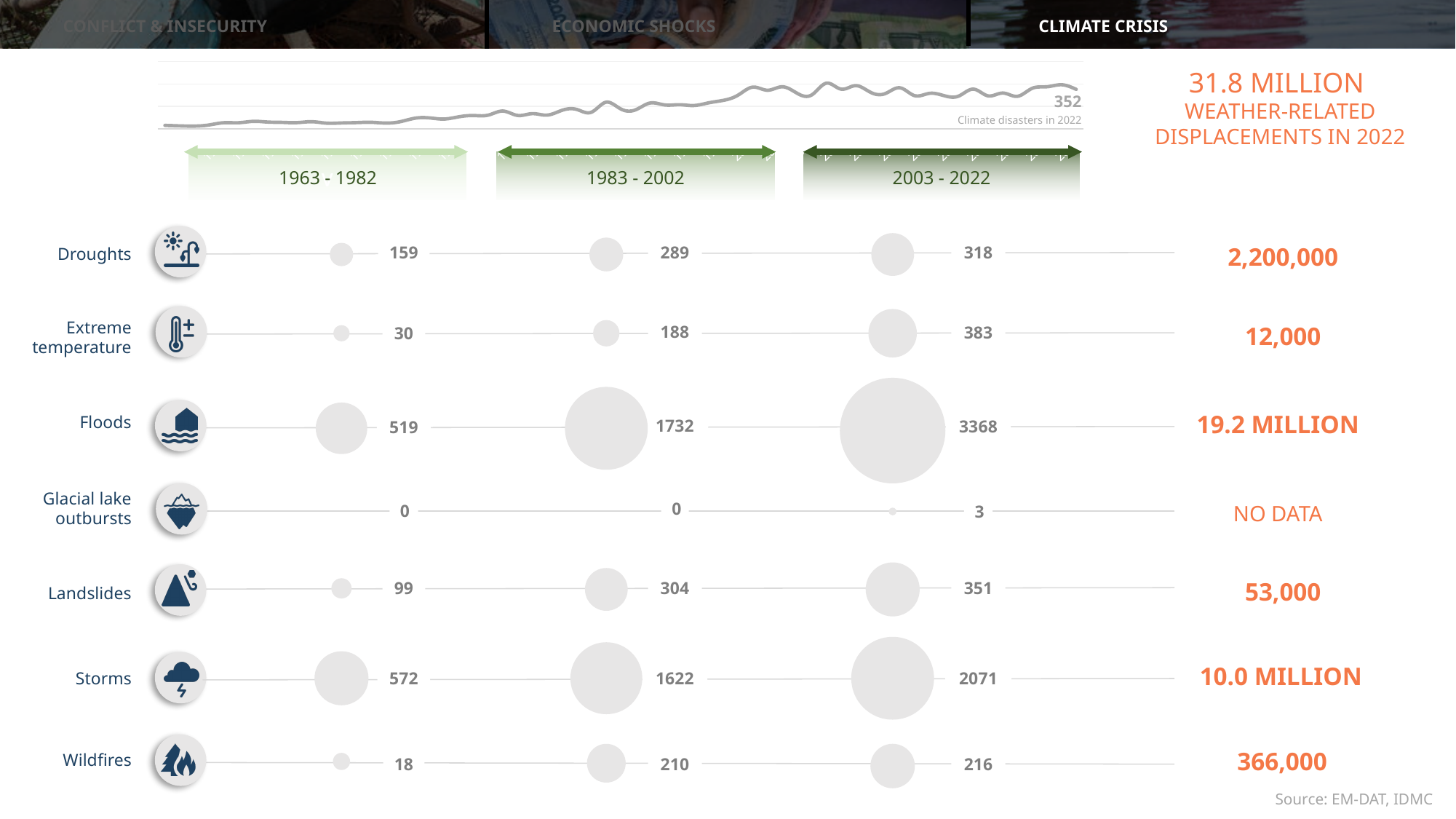
What value is labelled at the end of the line chart for climate disasters in 2022? 352 Which disaster type has the highest count in the period 2003 - 2022? Floods Which disaster type has the lowest count in the period 1963 - 1982? Glacial lake outbursts How many disaster types are listed in the chart? 7 How many wildfires are recorded for 1963 - 1982? 18 What is the number of storms in the period 1983 - 2002? 1622 How many weather-related displacements were caused by storms in 2022? 10.0 MILLION Do the counts for landslides rise or fall across the three periods from 1963 - 1982 to 2003 - 2022? Rise How many floods are shown for the period 2003 - 2022? 3368 Which is larger: the number of droughts in 2003 - 2022 or the number of extreme temperature events in 2003 - 2022? Extreme temperature (383) What is the total number of weather-related displacements in 2022 stated on the slide? 31.8 MILLION What is the difference between the number of floods in 2003 - 2022 and in 1983 - 2002? 1636